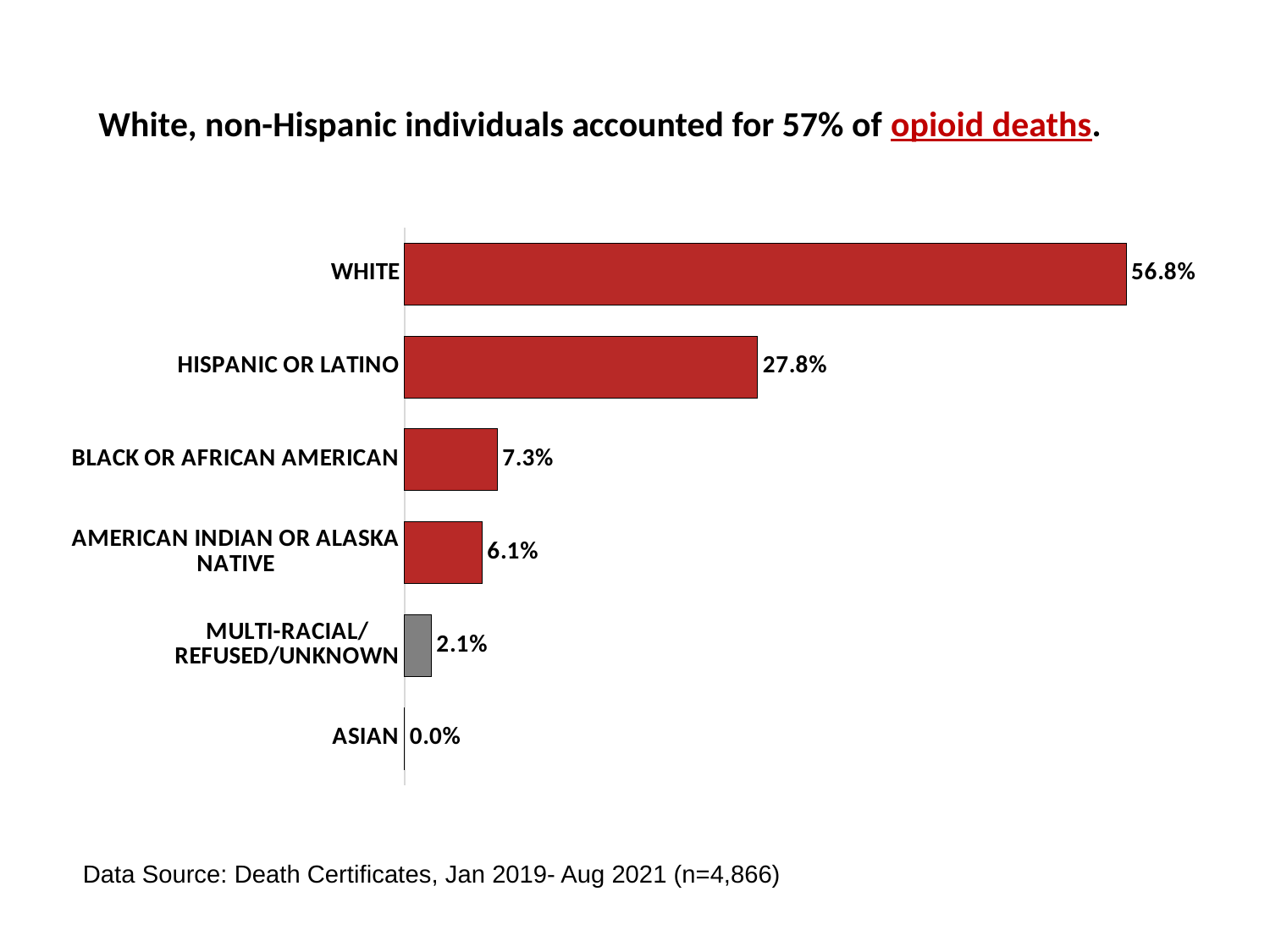
What is the value shown for Hispanic or Latino? 27.8% What type of chart is shown on the slide? Bar chart Which is larger, the value for Black or African American or the value for American Indian or Alaska Native? Black or African American Which category has the highest percentage of opioid deaths? White What percentage is shown for Black or African American? 7.3% What percentage of opioid deaths were among White individuals? 56.8% Which bar is coloured grey rather than red? Multi-Racial/Refused/Unknown What is the difference between the White and Hispanic or Latino percentages? 29.0% How many categories are shown in the chart? 6 Which category has the lowest percentage of opioid deaths? Asian What is the value for American Indian or Alaska Native? 6.1% What percentage is shown for Multi-Racial/Refused/Unknown? 2.1%